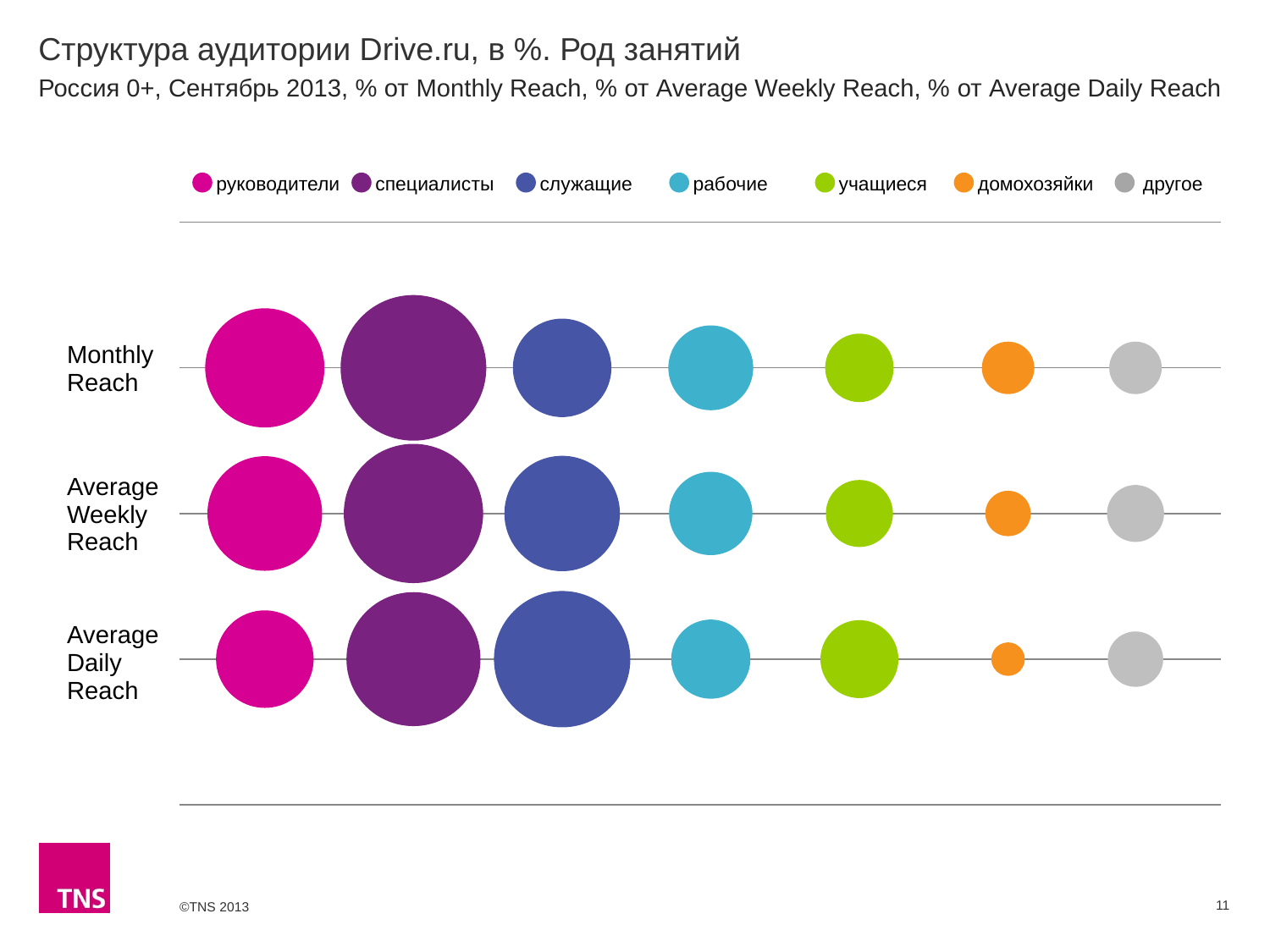
Which legend entry is shown in orange? домохозяйки Which occupation group has the smallest bubble in the Average Daily Reach row? домохозяйки Does the bubble for служащие grow or shrink from Monthly Reach to Average Daily Reach? grow Which occupation group has the largest bubble in the Average Weekly Reach row? специалисты Does the bubble for руководители grow or shrink from Monthly Reach to Average Daily Reach? shrink How many series does the legend list? 7 What kind of chart is shown on the slide? bubble chart In the Monthly Reach row, which bubble is larger: руководители or служащие? руководители What is the label of the first (top) row of the chart? Monthly Reach How many reach categories (rows) are plotted on the chart? 3 Which occupation group has the largest bubble in the Monthly Reach row? специалисты In the Average Daily Reach row, which bubble is larger: служащие or руководители? служащие